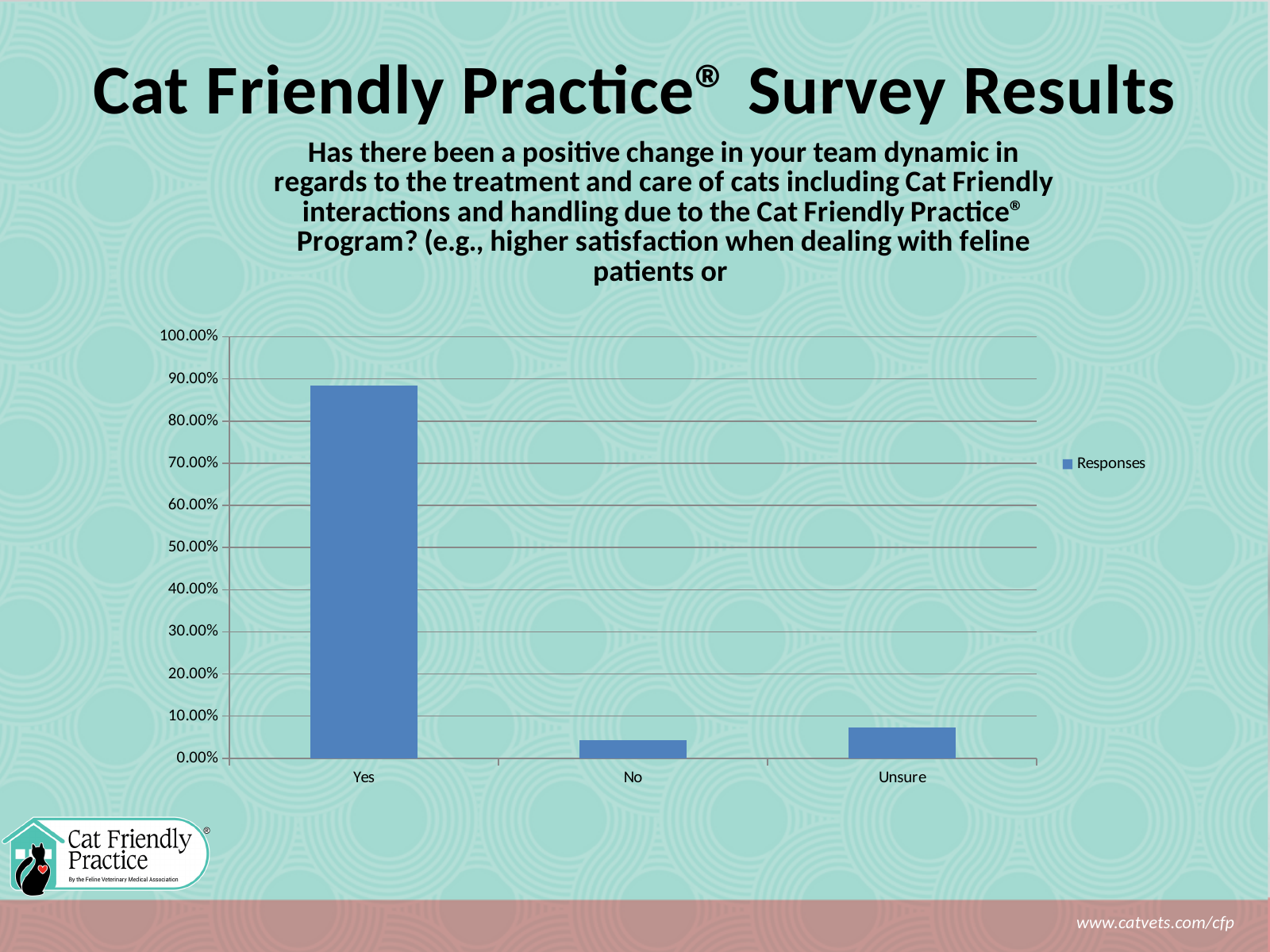
What is the name of the series shown in the legend? Responses Which category has the lowest value? No Is the value for Yes greater or less than 90.00%? less Which is larger, the value for Unsure or the value for No? Unsure Is the value for Unsure greater or less than 10.00%? less How many categories are shown on the x axis? 3 How many series does the legend list? 1 What is the highest value shown on the y axis? 100.00% Is the value for No greater or less than 10.00%? less Which category has the highest value? Yes What kind of chart is shown on the slide? bar chart